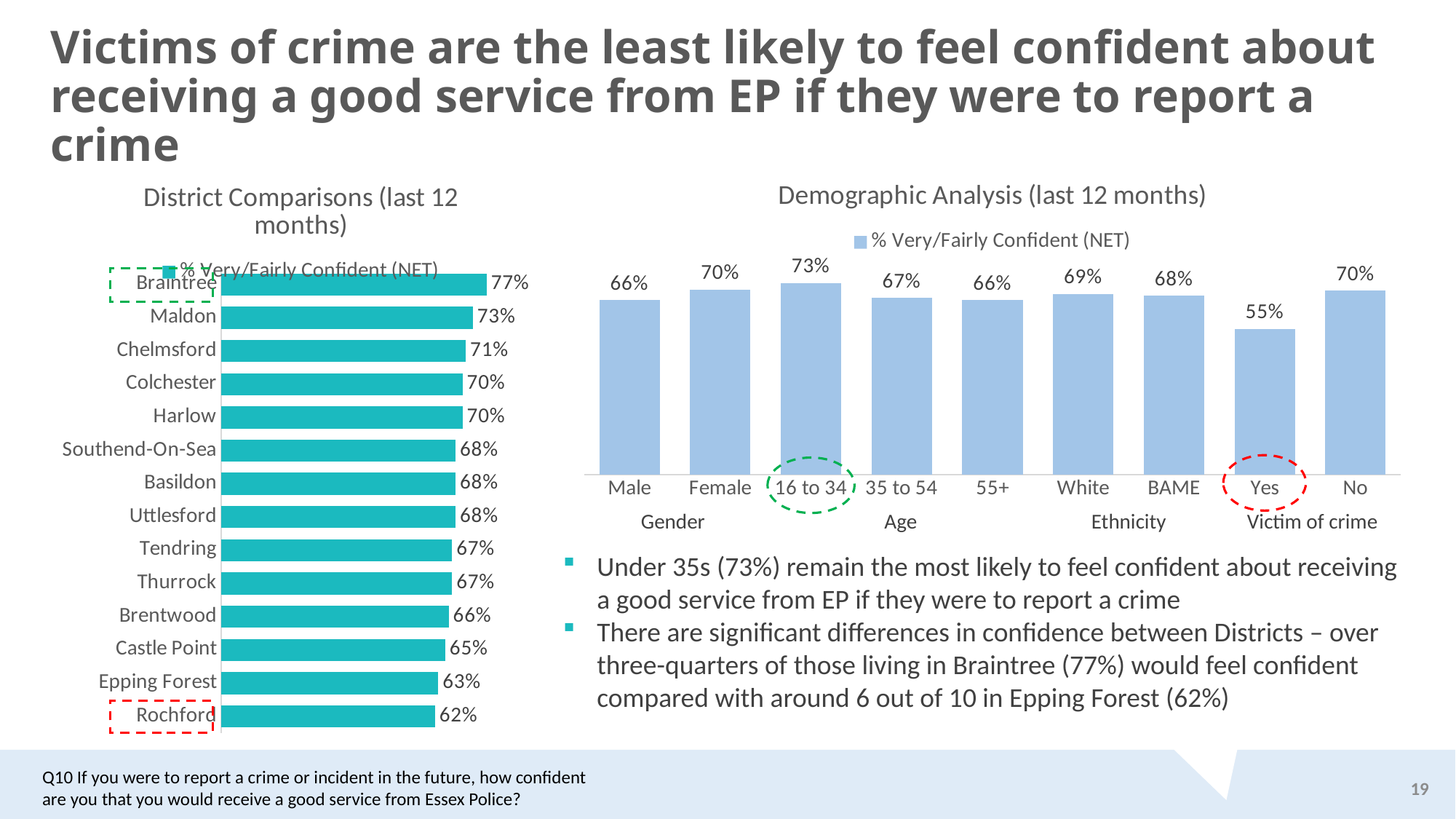
In the District Comparisons chart, which district has the highest value? Braintree In the Demographic Analysis chart, which is larger, Female or Male? Female In the Demographic Analysis chart, which category has the lowest value? Yes In the District Comparisons chart, what is the difference between Braintree and Rochford? 15 percentage points In the District Comparisons chart, what is the value for Maldon? 73% In the Demographic Analysis chart, how many bars are shown? 9 In the Demographic Analysis chart, what is the difference between No and Yes under Victim of crime? 15 percentage points In the District Comparisons chart, how many districts are shown? 14 What type of chart is the Demographic Analysis chart? Bar chart In the Demographic Analysis chart, what is the value for 16 to 34? 73% In the District Comparisons chart, which district has the lowest value? Rochford In the District Comparisons chart, what is the value for Castle Point? 65%